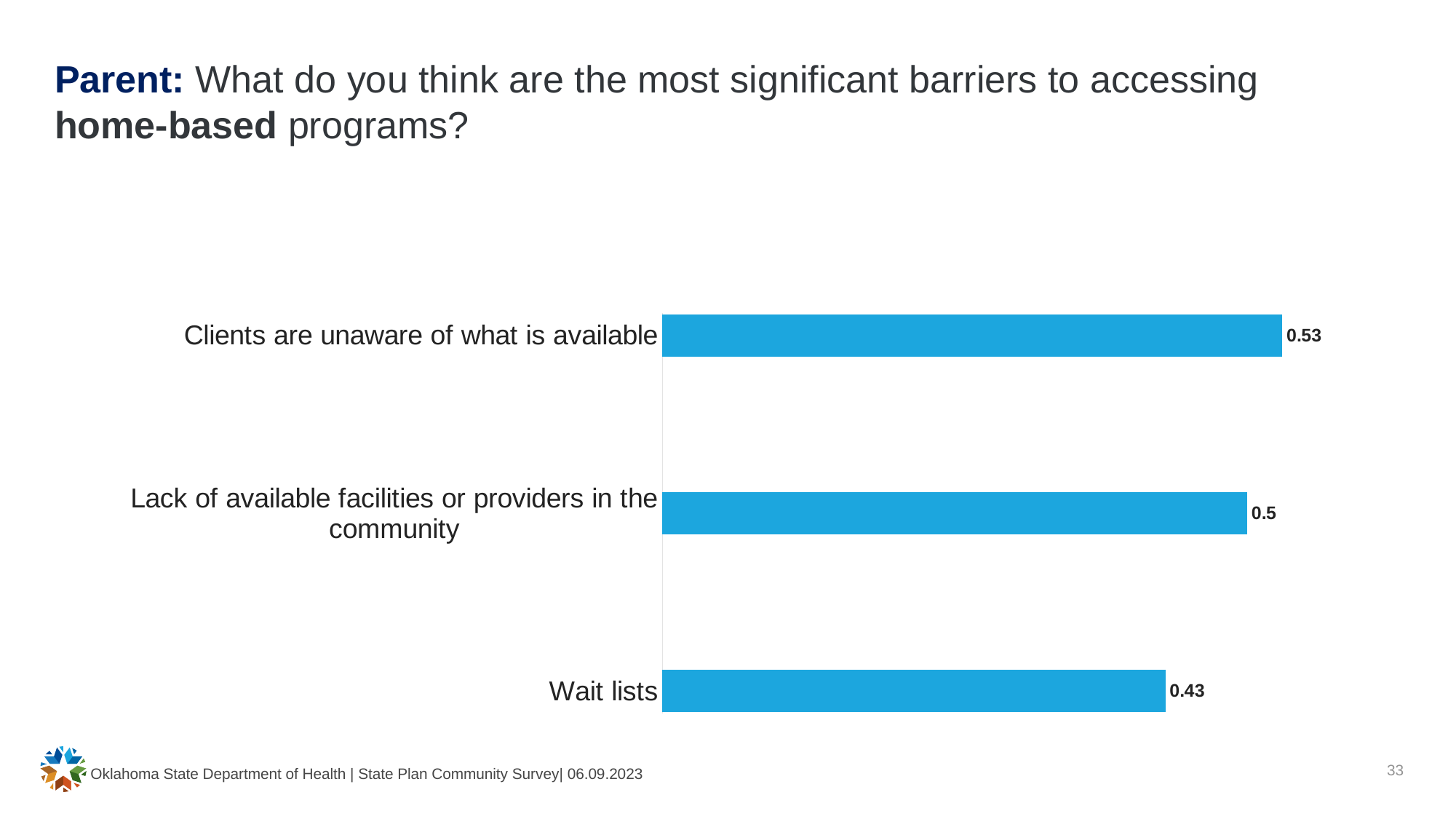
What is the difference between the values for "Clients are unaware of what is available" and "Wait lists"? 0.1 Which barrier has the lowest value? Wait lists What colour are the bars in the chart? Blue What question does the slide title say the chart is about? What do you think are the most significant barriers to accessing home-based programs? What kind of chart is shown on the slide? Bar chart What is the value for "Clients are unaware of what is available"? 0.53 Which barrier has the highest value? Clients are unaware of what is available What is the value for "Lack of available facilities or providers in the community"? 0.5 Which is larger: the value for "Lack of available facilities or providers in the community" or the value for "Wait lists"? Lack of available facilities or providers in the community How many barriers are shown in the chart? 3 What is the difference between the values for "Lack of available facilities or providers in the community" and "Wait lists"? 0.07 What is the value for "Wait lists"? 0.43